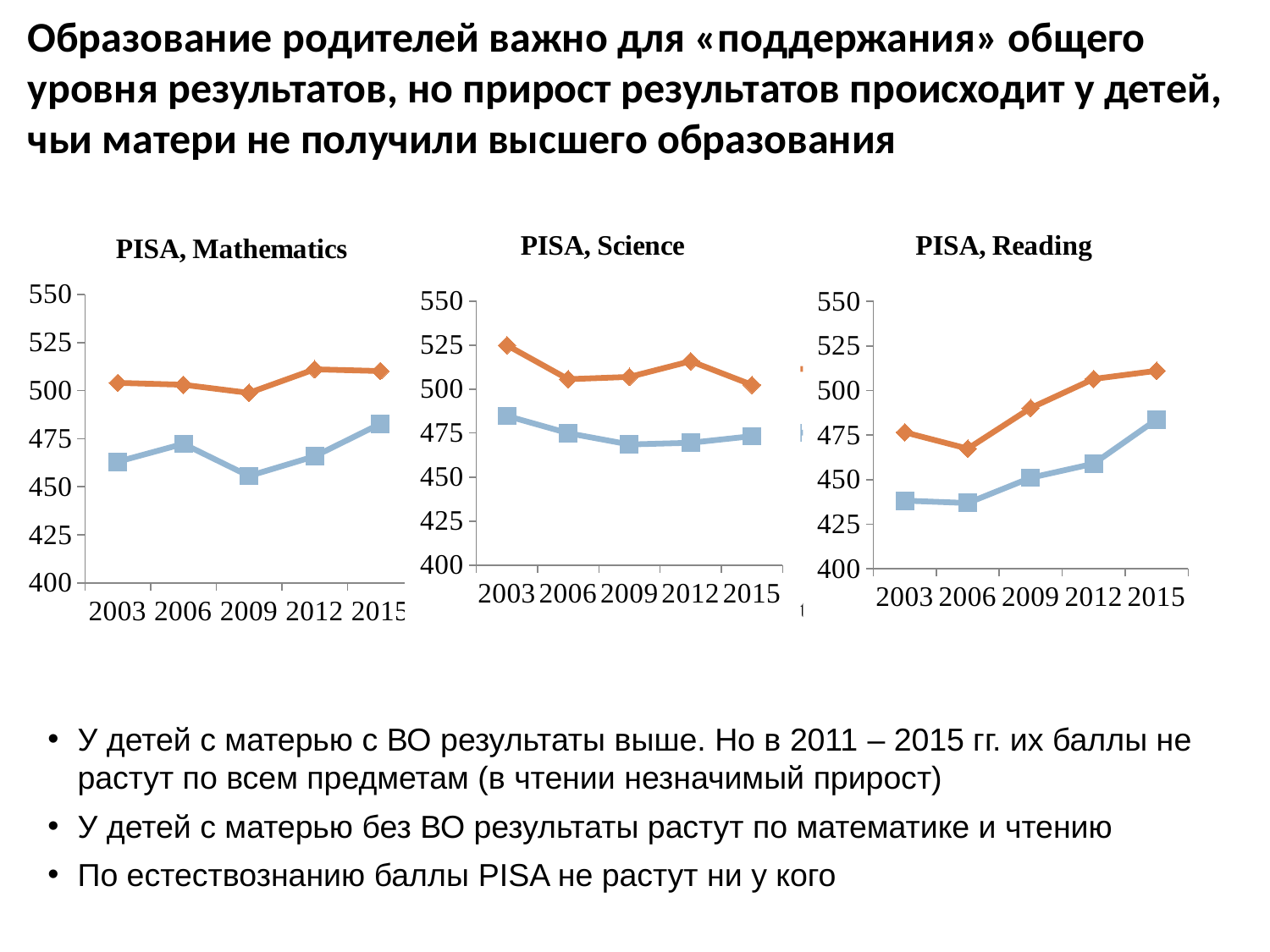
In the PISA, Science chart, does the blue square series rise or fall from 2003 to 2009? fall In the PISA, Mathematics chart, which series is higher in 2015, the orange diamond series or the blue square series? the orange diamond series In the PISA, Mathematics chart, in which year is the blue square series lowest? 2009 In the PISA, Science chart, in which year is the orange diamond series highest? 2003 In the PISA, Reading chart, is the value of the blue square series in 2003 greater or less than 450? less How many years are shown on the x axis of the PISA, Science chart? 5 What kind of chart is the PISA, Mathematics chart? line chart In the PISA, Reading chart, does the blue square series rise or fall from 2006 to 2015? rise In the PISA, Mathematics chart, is the value of the orange diamond series in 2012 greater or less than 500? greater What is the title of the rightmost chart on the slide? PISA, Reading In the PISA, Reading chart, in which year is the blue square series highest? 2015 In the PISA, Science chart, is the value of the orange diamond series in 2003 greater or less than 500? greater